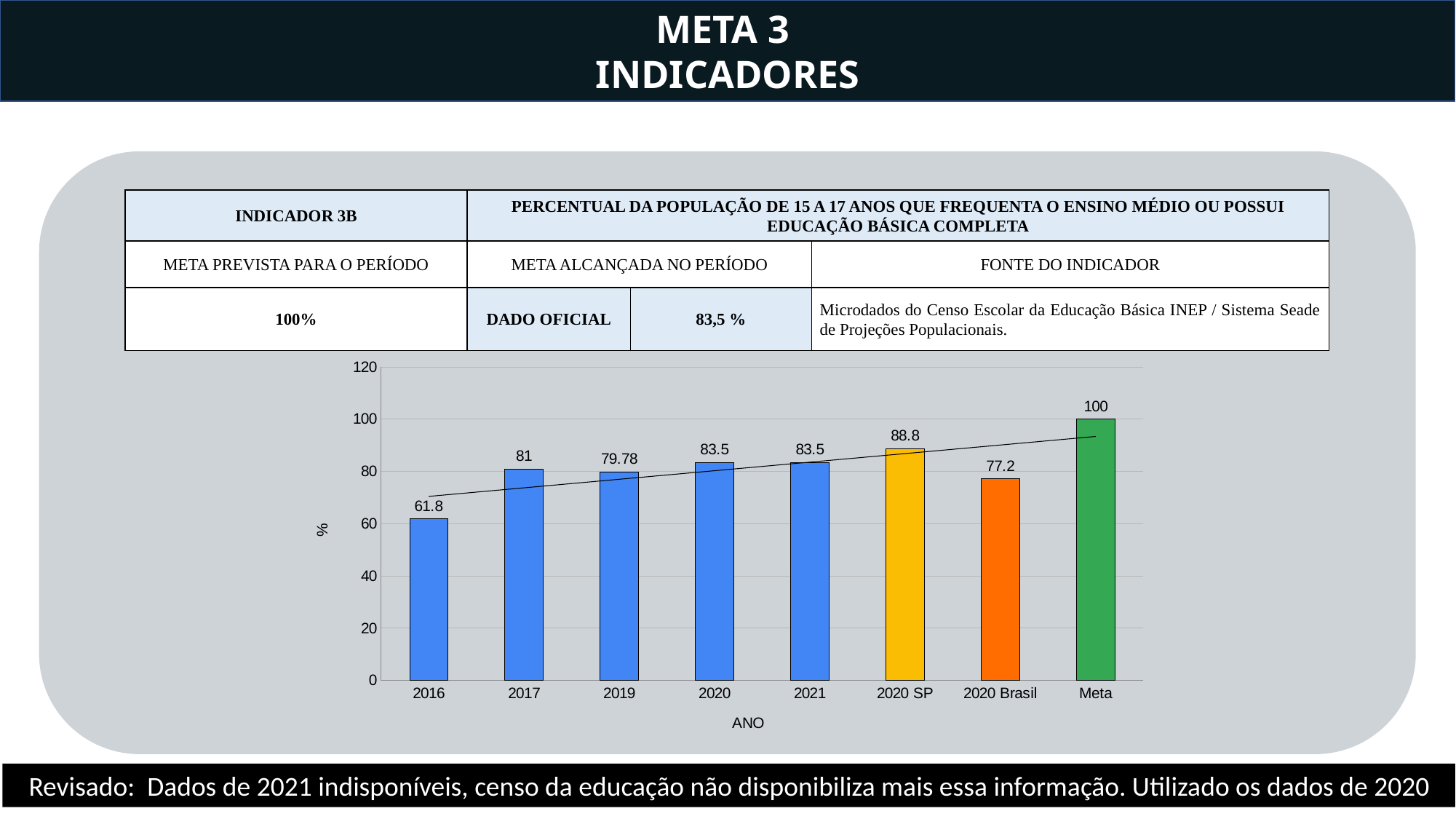
What is the value for 2020 Brasil? 77.2 Which is larger, the value for 2020 SP or the value for 2020 Brasil? 2020 SP Is the value for 2017 greater or less than 100? less What is the difference between the Meta value and the 2021 value? 16.5 How many bars are shown in the chart? 8 What is the value for 2019? 79.78 Which category has the highest value? Meta What is the label of the y axis? % Which category has the lowest value? 2016 What kind of chart is shown on the slide? bar chart What is the value for 2020 SP? 88.8 What is the value for 2016? 61.8